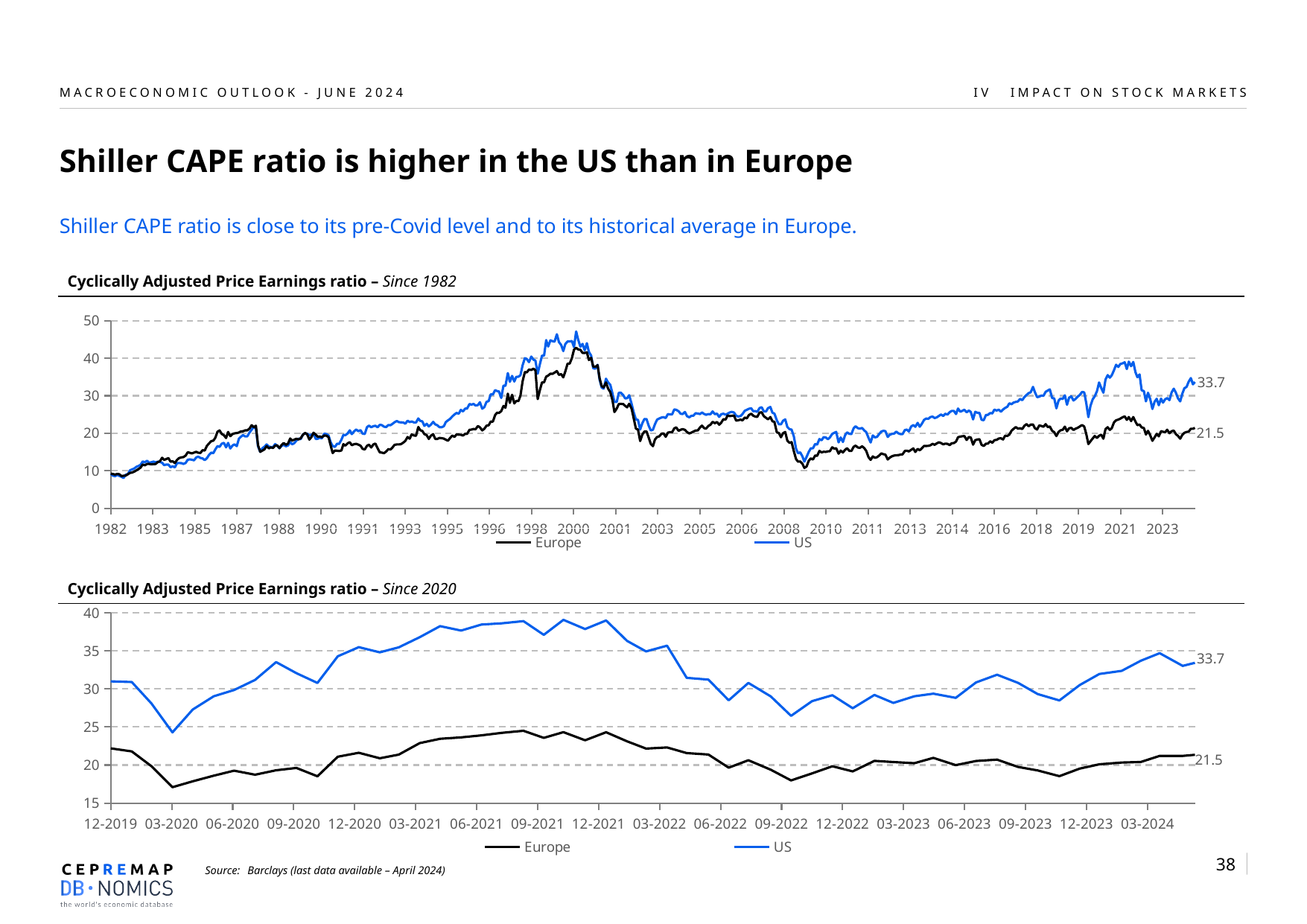
In the 'Since 1982' chart, what is the latest value shown for the US series? 33.7 In the 'Since 2020' chart, what is the latest value shown for the Europe series? 21.5 In the 'Since 1982' chart, is the peak of the US series around 2000 greater or less than 40? greater In the 'Since 2020' chart, is the value for Europe in 09-2021 greater or less than 20? greater In the 'Since 1982' chart, what is the difference between the latest US value and the latest Europe value? 12.2 In the 'Since 1982' chart, what is the latest value shown for the Europe series? 21.5 In the 'Since 2020' chart, is the value for the US in 03-2020 greater or less than 30? less In the 'Since 2020' chart, which series has the higher latest value, US or Europe? US How many series does the legend of the 'Since 1982' chart list? 2 In the 'Since 2020' chart, does the US series rise or fall between 12-2021 and 09-2022? fall What kind of chart is the 'Since 2020' chart? Line chart Which colour is used for the US series in both charts? Blue